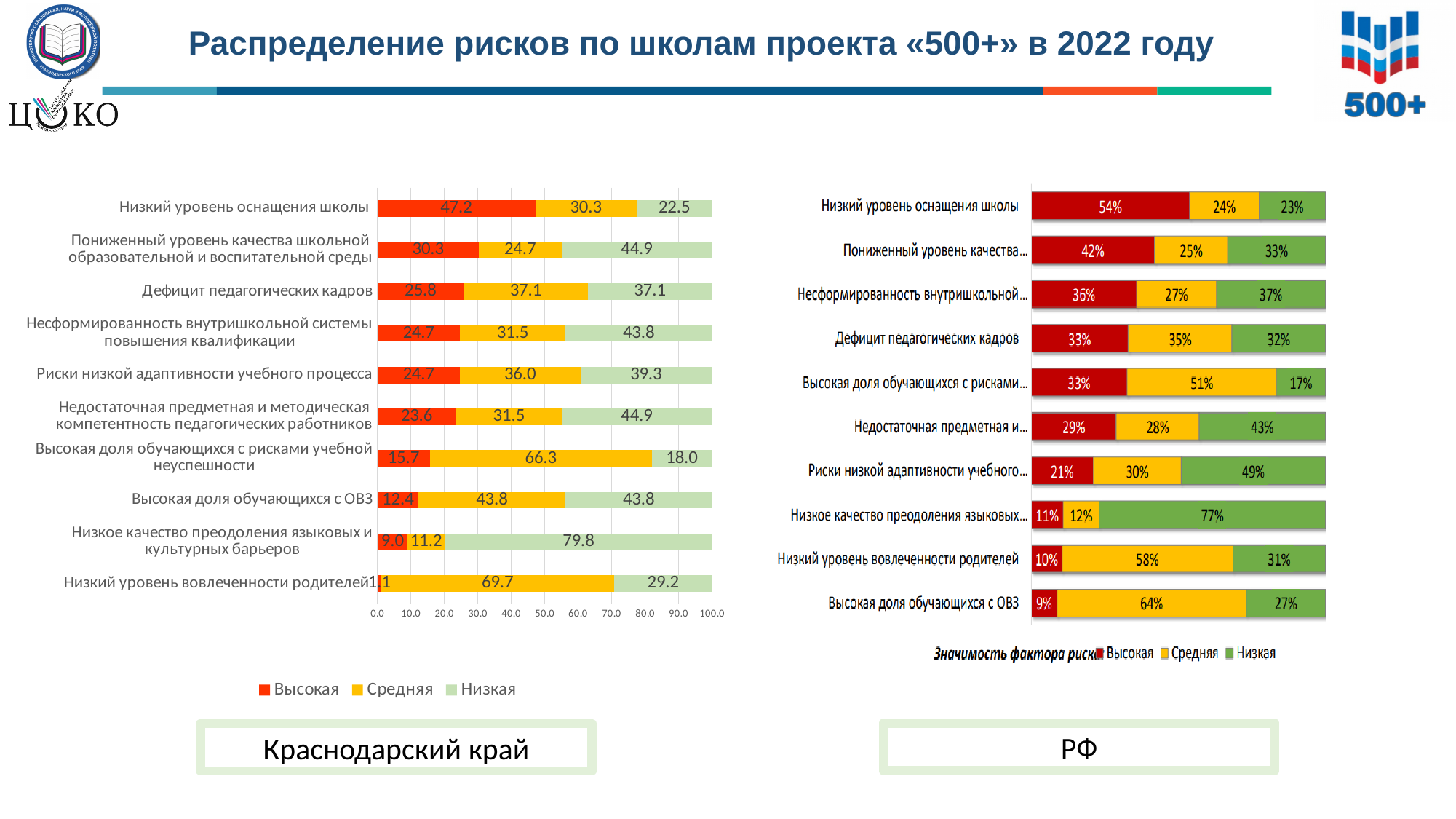
On the Краснодарский край chart, what is the Высокая value for Низкий уровень оснащения школы? 47.2 On the РФ chart, which category has the highest Низкая value? Низкое качество преодоления языковых... On the Краснодарский край chart, what is the Низкая value for Низкое качество преодоления языковых и культурных барьеров? 79.8 How many series does the legend of the РФ chart list? 3 On the РФ chart, what is the Высокая value for Низкий уровень оснащения школы? 54% On the Краснодарский край chart, which category has the highest Средняя value? Низкий уровень вовлеченности родителей On the Краснодарский край chart, which category has the lowest Высокая value? Низкий уровень вовлеченности родителей What type of chart is the Краснодарский край chart? Stacked bar chart On the РФ chart, what is the Средняя value for Высокая доля обучающихся с ОВЗ? 64% On the РФ chart, is the Высокая value larger for Дефицит педагогических кадров or for Риски низкой адаптивности учебного...? Дефицит педагогических кадров On the Краснодарский край chart, what is the difference between the Средняя and Высокая values for Дефицит педагогических кадров? 11.3 On the Краснодарский край chart, how many categories are shown? 10